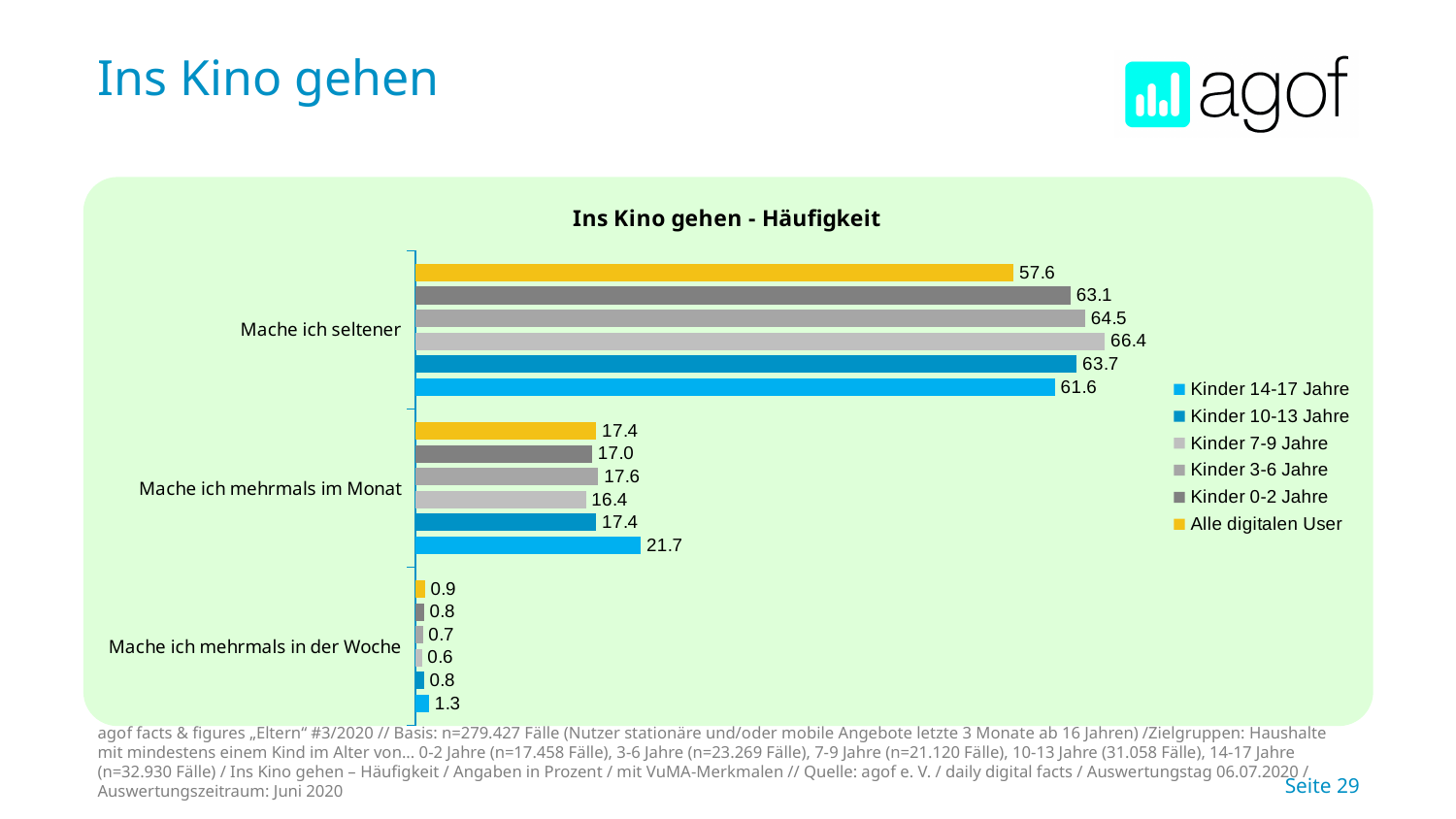
How many series does the legend list? 6 Which series has the lowest value in the category "Mache ich mehrmals in der Woche"? Kinder 7-9 Jahre What is the value for Kinder 14-17 Jahre in the category "Mache ich mehrmals im Monat"? 21.7 What kind of chart is shown on the slide? Bar chart What is the value for Alle digitalen User in the category "Mache ich mehrmals in der Woche"? 0.9 Which series has the highest value in the category "Mache ich seltener"? Kinder 7-9 Jahre Which series is shown in yellow in the chart? Alle digitalen User How many categories are shown on the vertical axis of the chart? 3 What is the title of the chart? Ins Kino gehen - Häufigkeit What is the value for Kinder 7-9 Jahre in the category "Mache ich seltener"? 66.4 What is the difference between Kinder 14-17 Jahre and Alle digitalen User in the category "Mache ich mehrmals im Monat"? 4.3 In the category "Mache ich seltener", which is larger: Kinder 0-2 Jahre or Kinder 14-17 Jahre? Kinder 0-2 Jahre